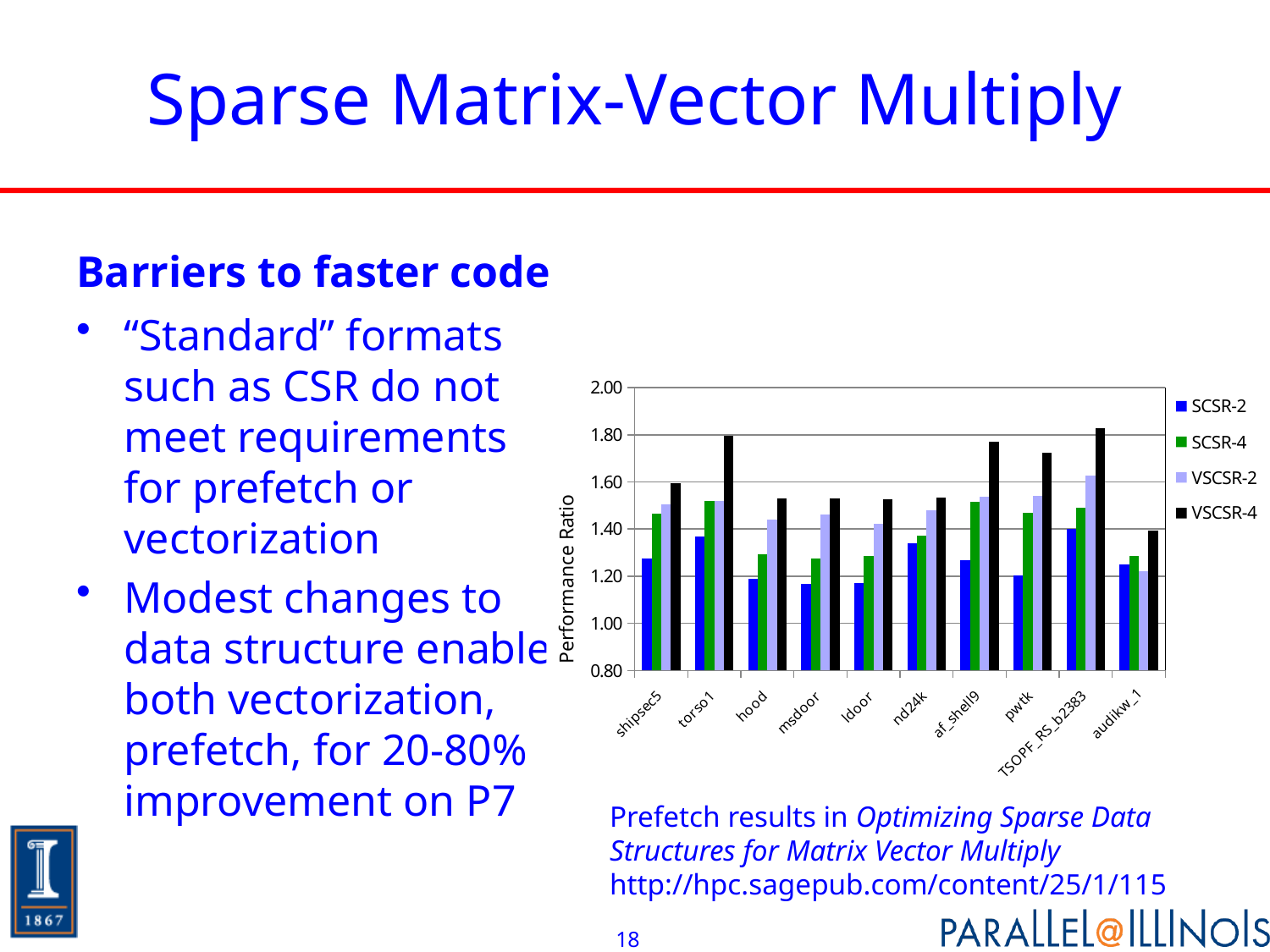
What kind of chart is shown on the slide? bar chart What is the label of the chart's vertical axis? Performance Ratio For hood, which is larger: the VSCSR-2 value or the SCSR-4 value? VSCSR-2 Is the VSCSR-2 value for TSOPF_RS_b2383 greater or less than 1.40? greater Is the VSCSR-4 value for torso1 greater or less than 1.60? greater Among the VSCSR-4 bars, which matrix has the lowest performance ratio? audikw_1 How many matrices (categories) are shown along the x axis of the chart? 10 Which colour represents the VSCSR-4 series in the chart? black How many series does the chart's legend list? 4 Is the VSCSR-4 value for af_shell9 greater or less than 1.60? greater Among the VSCSR-2 bars, which matrix has the highest performance ratio? TSOPF_RS_b2383